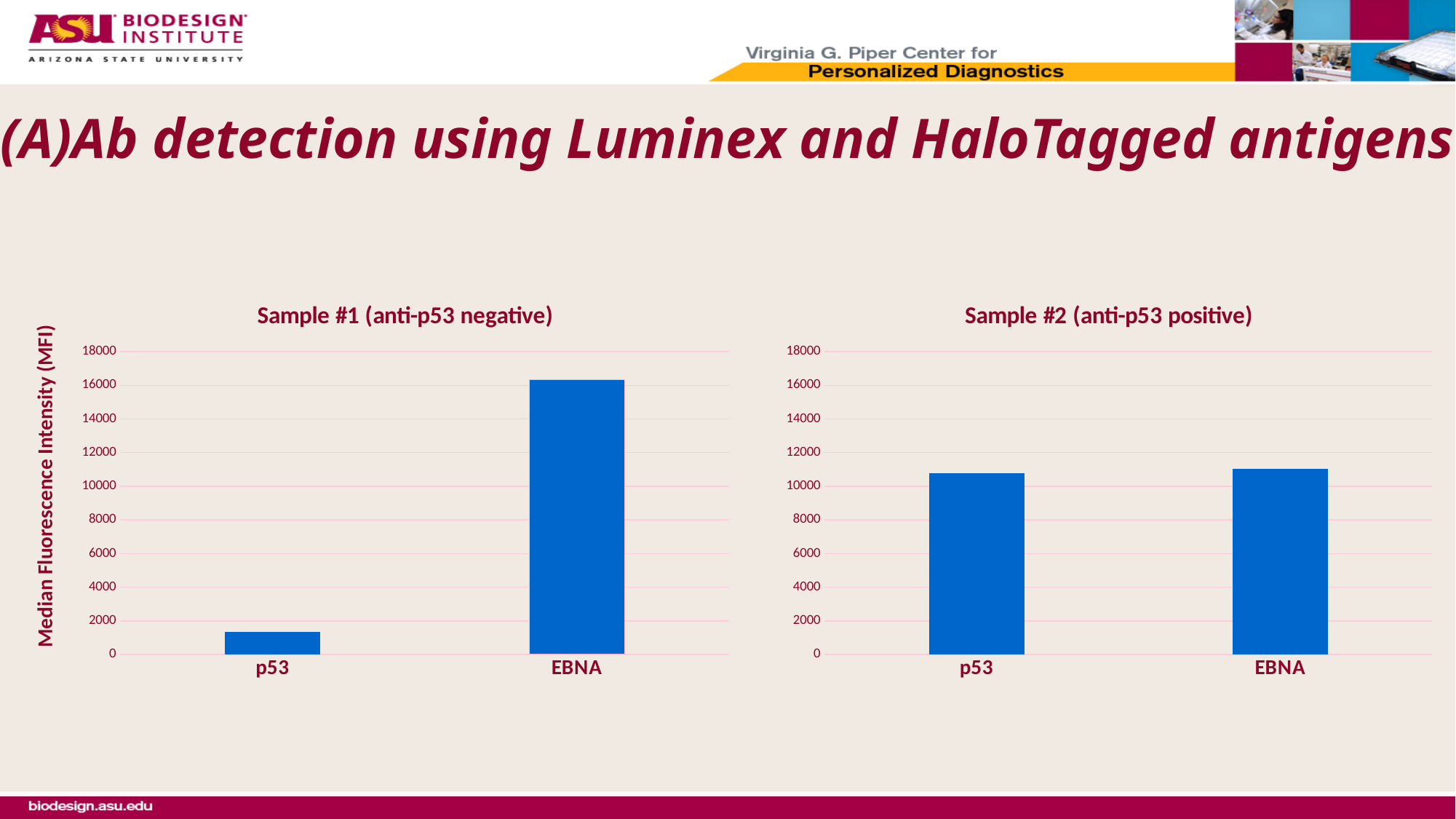
In the chart titled "Sample #1 (anti-p53 negative)", is the value for EBNA greater or less than 16000? greater In the chart titled "Sample #1 (anti-p53 negative)", is the value for p53 greater or less than 2000? less In the chart titled "Sample #2 (anti-p53 positive)", is the value for p53 greater or less than 4000? greater In the chart titled "Sample #1 (anti-p53 negative)", what kind of chart is shown? bar chart In the chart titled "Sample #2 (anti-p53 positive)", how many categories are plotted on the x axis? 2 What is the title of the chart on the right side of the slide? Sample #2 (anti-p53 positive) In the chart titled "Sample #1 (anti-p53 negative)", which is larger, the value for p53 or the value for EBNA? EBNA In the chart titled "Sample #1 (anti-p53 negative)", which category has the lowest value? p53 What is the label on the y axis shared by the two charts? Median Fluorescence Intensity (MFI) In the chart titled "Sample #1 (anti-p53 negative)", which category has the highest value? EBNA